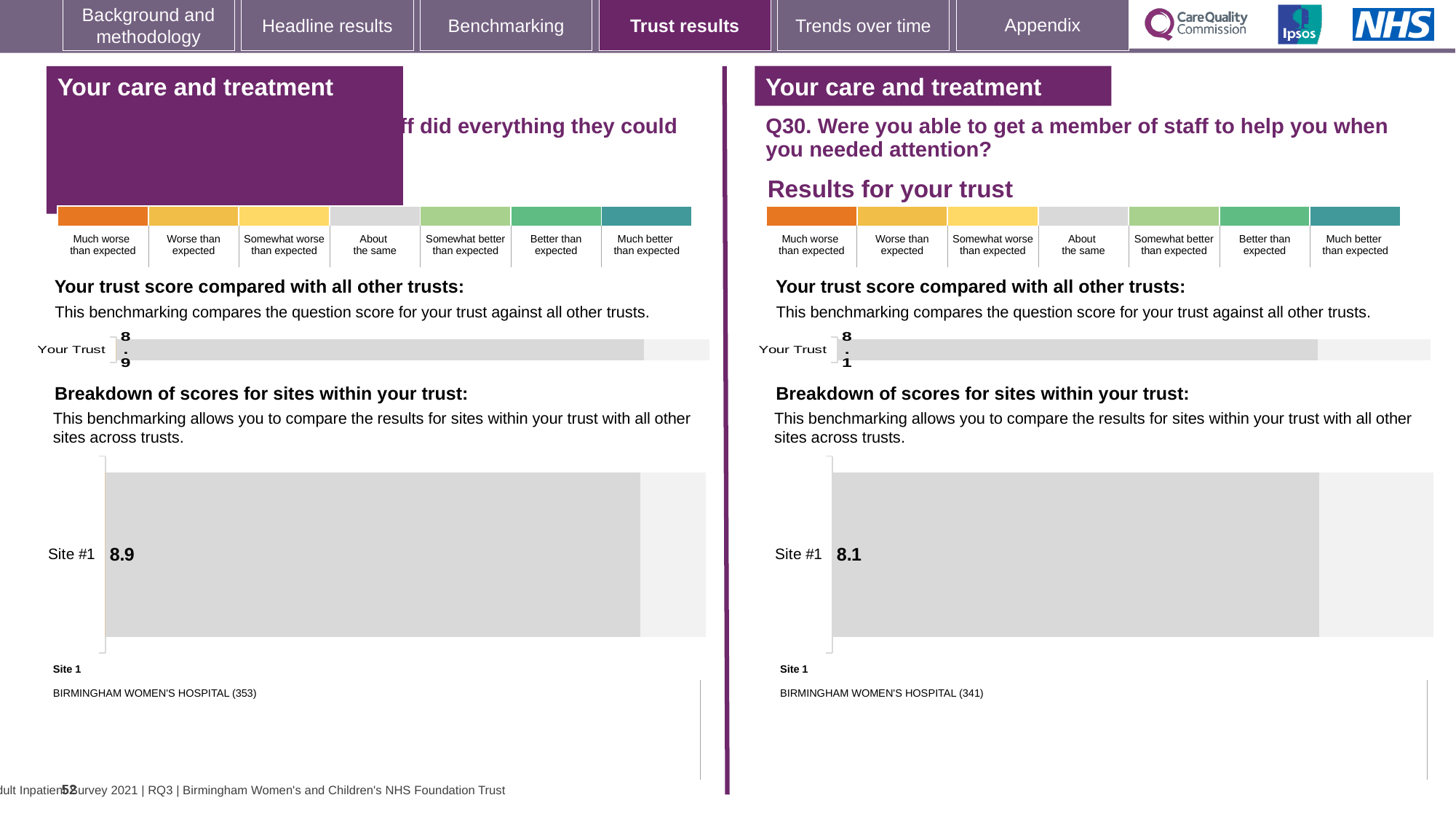
On the right-hand panel (Q30), what is the score shown for Your Trust in the 'Your trust score compared with all other trusts' chart? 8.1 Which panel shows the higher Your Trust score, the left-hand panel or the right-hand panel (Q30)? The left-hand panel How many sites are shown in the 'Breakdown of scores for sites within your trust' chart on the right-hand panel (Q30)? 1 On the right-hand panel (Q30), is the Site #1 score greater or less than the Site #1 score on the left-hand panel? less On the left-hand panel, what is the score for Site #1 in the 'Breakdown of scores for sites within your trust' chart? 8.9 What is the difference between the Your Trust score on the left-hand panel and the Your Trust score on the right-hand panel (Q30)? 0.8 On the right-hand panel (Q30), what is the score for Site #1 in the 'Breakdown of scores for sites within your trust' chart? 8.1 What number appears in brackets after BIRMINGHAM WOMEN'S HOSPITAL beneath the breakdown chart on the left-hand panel? 353 Which hospital is listed as Site 1 beneath the breakdown chart on the right-hand panel (Q30)? BIRMINGHAM WOMEN'S HOSPITAL On the left-hand panel, what is the score shown for Your Trust in the 'Your trust score compared with all other trusts' chart? 8.9 What kind of chart is used to show the Site #1 score on the right-hand panel (Q30)? Bar chart